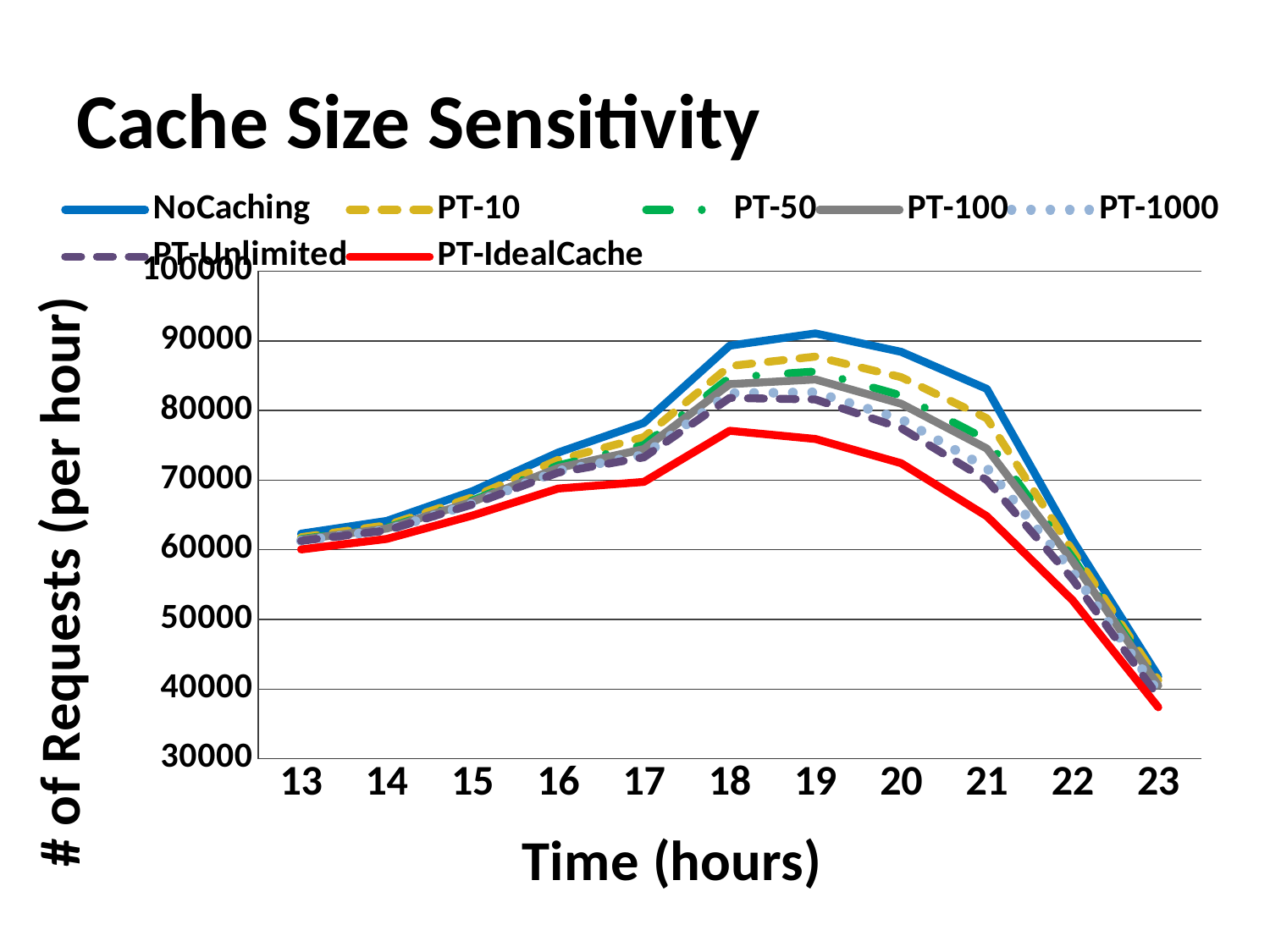
What kind of chart is shown on the slide? line chart Do the NoCaching values rise or fall from hour 19 to hour 23? fall Which series has the lowest value at hour 19? PT-IdealCache Which is larger at hour 18, NoCaching or PT-IdealCache? NoCaching Is the value for PT-IdealCache at hour 21 greater or less than 70000? less Which series has the highest value at hour 19? NoCaching What is the title of the chart? Cache Size Sensitivity What is the label of the y axis? # of Requests (per hour) How many series does the legend list? 7 Is the value for PT-IdealCache at hour 23 greater or less than 40000? less Is the value for NoCaching at hour 18 greater or less than 80000? greater How many time points are plotted along the x axis? 11